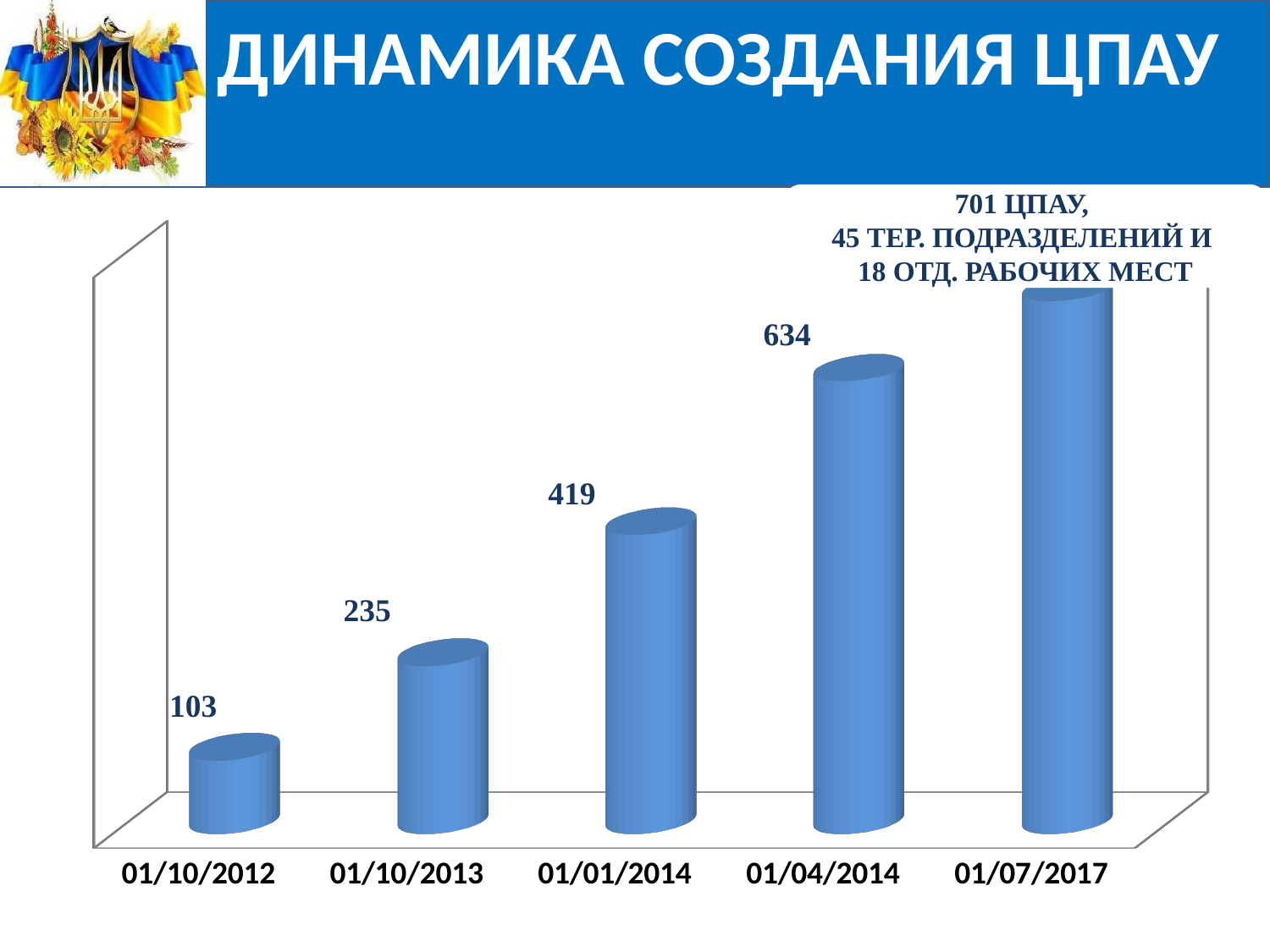
What is the value for 01/10/2013? 235 How many ЦПАУ are shown for 01/07/2017? 701 What is the difference between the values for 01/04/2014 and 01/01/2014? 215 Which date has the highest value? 01/07/2017 What is the value for 01/01/2014? 419 What is the value for 01/04/2014? 634 What is the value for 01/10/2012? 103 What kind of chart is shown on the slide? bar chart How many dates are shown on the x axis? 5 Which date has the lowest value? 01/10/2012 Do the values rise or fall from 01/10/2012 to 01/07/2017? rise Which is larger, the value for 01/10/2013 or the value for 01/01/2014? 01/01/2014